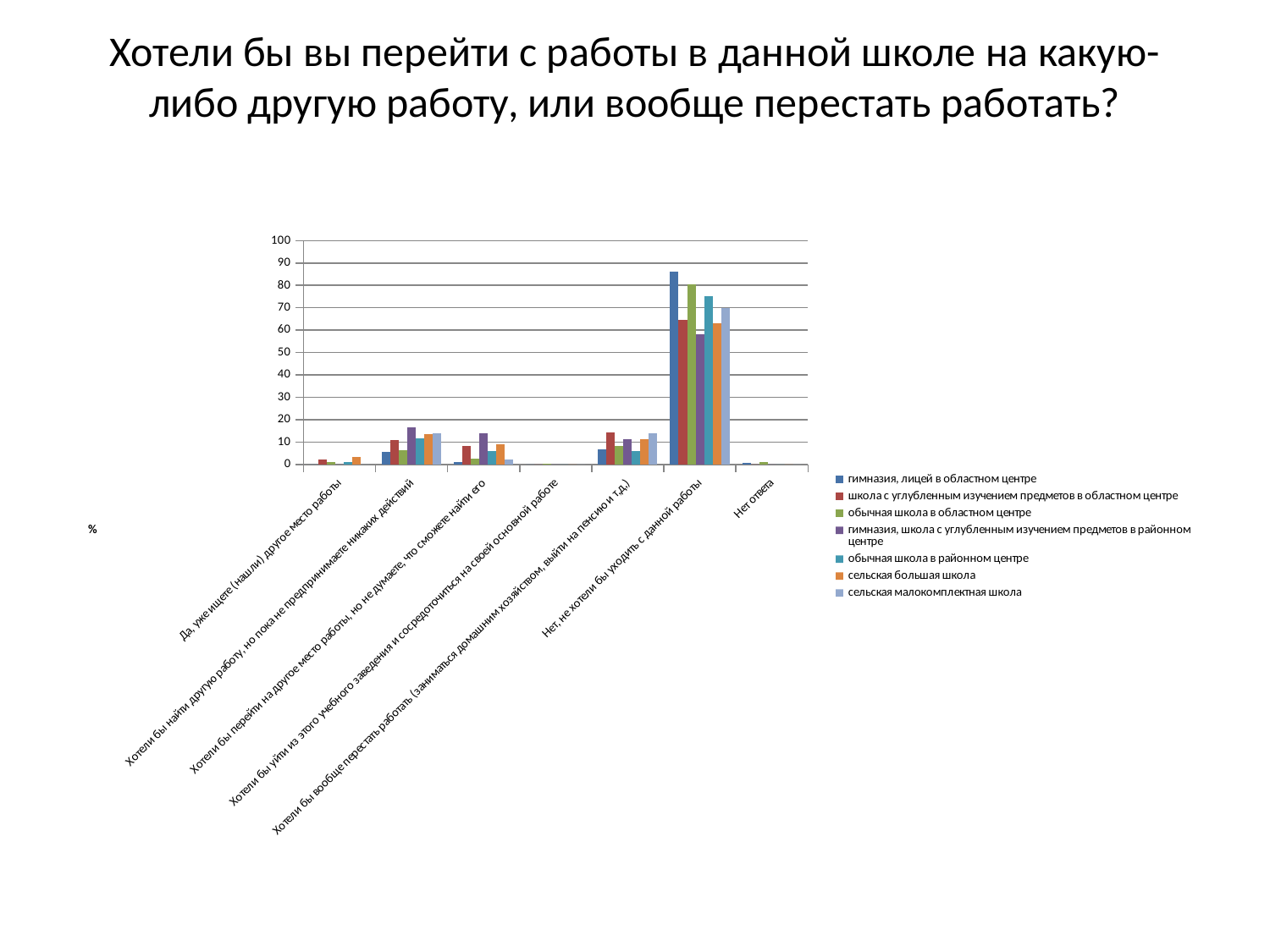
Is the value for "гимназия, школа с углубленным изучением предметов в районном центре" in the category "Нет, не хотели бы уходить с данной работы" greater or less than 60? less Is the value for "обычная школа в районном центре" in the category "Нет, не хотели бы уходить с данной работы" greater or less than 70? greater Which response category has the highest values across all school types? Нет, не хотели бы уходить с данной работы Which series is shown in orange in the legend? сельская большая школа In the category "Хотели бы перейти на другое место работы, но не думаете, что сможете найти его", which is larger: the value for "обычная школа в районном центре" or for "гимназия, школа с углубленным изучением предметов в районном центре"? гимназия, школа с углубленным изучением предметов в районном центре What kind of chart is shown on the slide? bar chart For the category "Нет, не хотели бы уходить с данной работы", which school type has the highest value? гимназия, лицей в областном центре How many response categories are shown along the x axis? 7 What unit is indicated on the vertical axis label of the chart? % How many series does the legend list? 7 Is the value for "гимназия, лицей в областном центре" in the category "Нет, не хотели бы уходить с данной работы" greater or less than 80? greater In the category "Хотели бы найти другую работу, но пока не предпринимаете никаких действий", which is larger: the value for "гимназия, лицей в областном центре" or for "гимназия, школа с углубленным изучением предметов в районном центре"? гимназия, школа с углубленным изучением предметов в районном центре